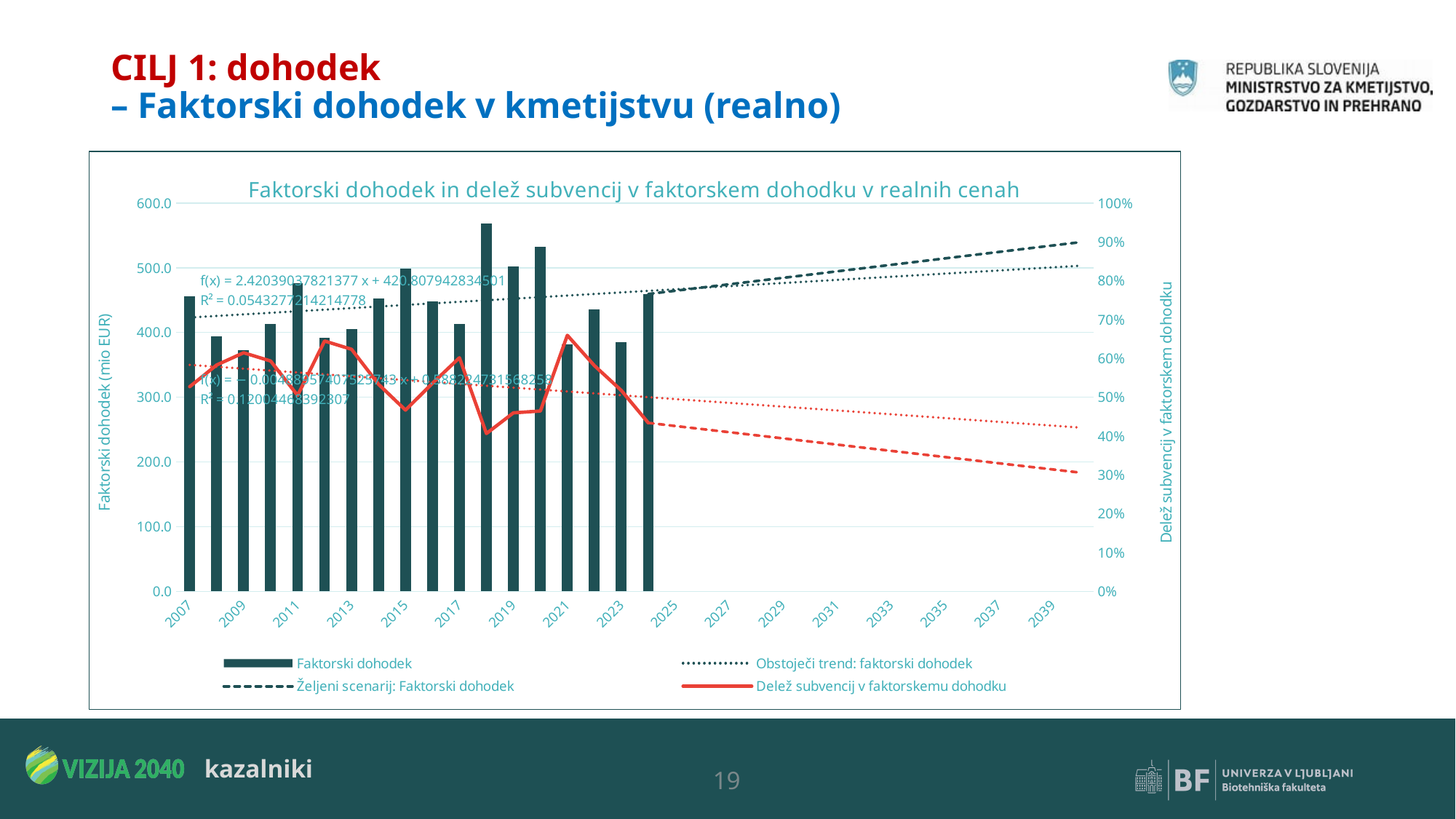
Is the Faktorski dohodek value for 2020 greater or less than 500.0? greater In which year is the Faktorski dohodek bar the highest? 2018 Which year has the larger Faktorski dohodek bar, 2011 or 2008? 2011 How many bars (years with Faktorski dohodek values) are plotted in the chart? 18 What kind of chart is shown on the slide? Combined bar and line chart Is the Delež subvencij v faktorskemu dohodku value for 2018 greater or less than 50%? less How many series does the chart legend list? 4 Is the Faktorski dohodek value for 2009 greater or less than 400.0? less What is the title of the chart? Faktorski dohodek in delež subvencij v faktorskem dohodku v realnih cenah Does the dashed 'Željeni scenarij: Faktorski dohodek' line rise or fall from 2024 to 2040? rise